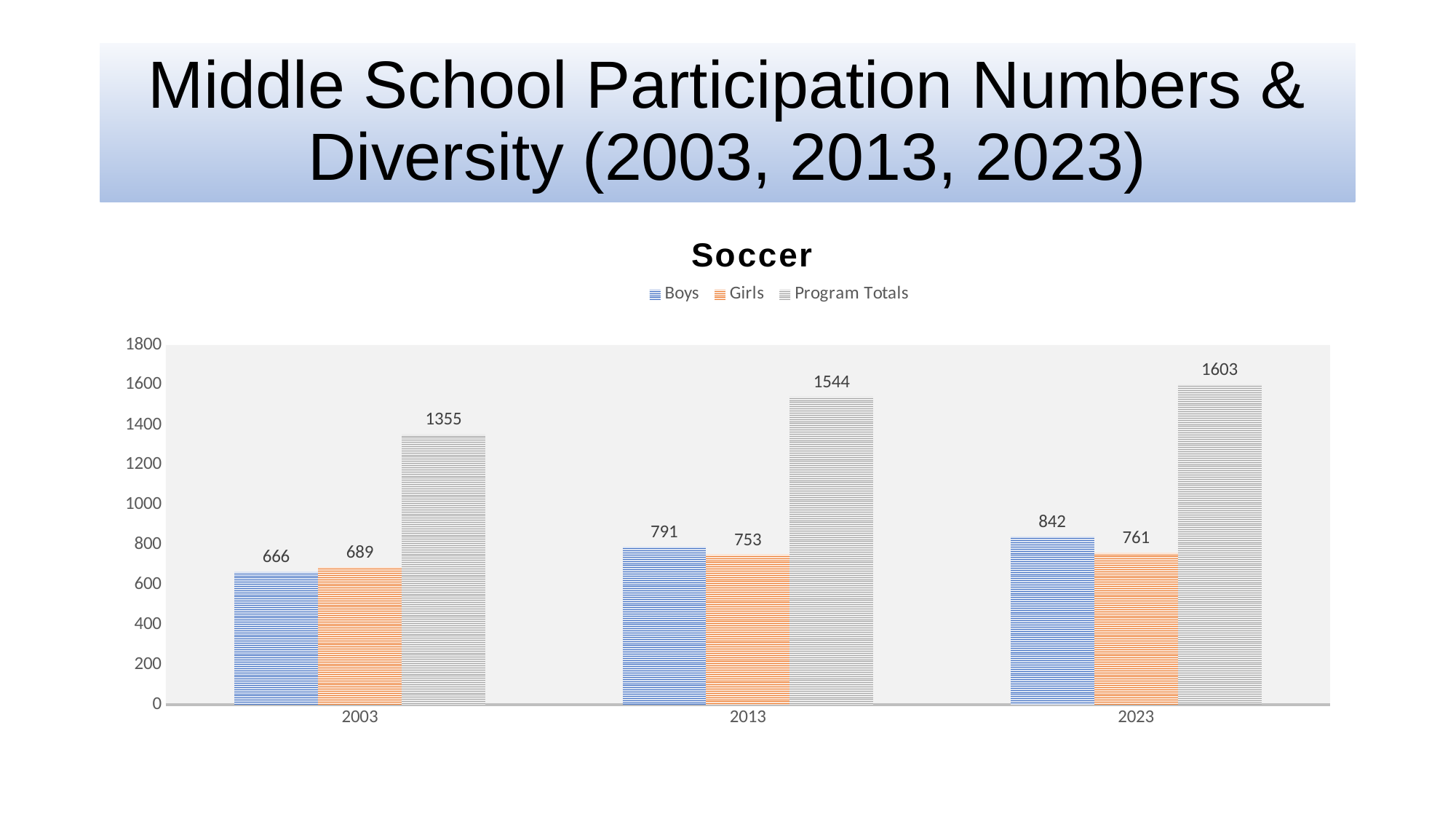
Which year has the highest Program Totals value? 2023 How many series does the legend list? 3 How many years are shown on the x axis? 3 Do the Girls values rise or fall from 2003 to 2023? rise Is the value for Boys in 2023 greater or less than 800? greater What kind of chart is shown? bar chart What is the value for Boys in 2003? 666 Which is larger in 2003, the value for Boys or the value for Girls? Girls What is the Program Totals value for 2023? 1603 What is the difference between the Program Totals for 2023 and 2003? 248 Which year has the lowest value for Boys? 2003 What is the value for Girls in 2013? 753